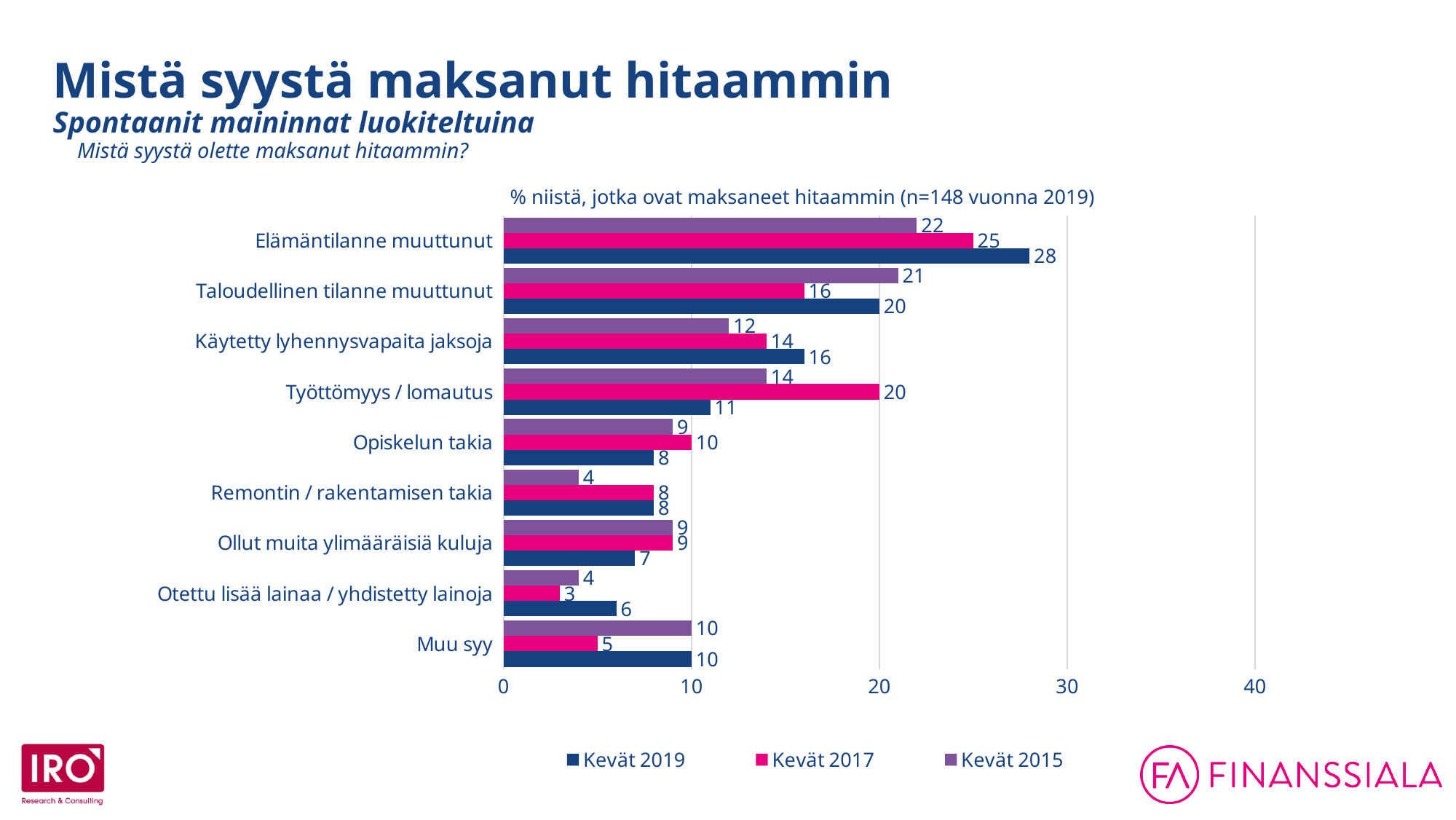
Which category has the lowest Kevät 2017 value? Otettu lisää lainaa / yhdistetty lainoja What is the Kevät 2019 value for Elämäntilanne muuttunut? 28 What is the difference between the Kevät 2019 and Kevät 2015 values for Elämäntilanne muuttunut? 6 What is the Kevät 2017 value for Työttömyys / lomautus? 20 What is the Kevät 2015 value for Taloudellinen tilanne muuttunut? 21 Which category has the highest Kevät 2019 value? Elämäntilanne muuttunut For Työttömyys / lomautus, which is larger: the Kevät 2017 value or the Kevät 2019 value? Kevät 2017 What kind of chart is shown on the slide? Bar chart How many series does the legend list? 3 How many categories are shown on the chart? 9 Is the Kevät 2019 value for Taloudellinen tilanne muuttunut greater or less than 10? greater Which series is shown in pink in the legend? Kevät 2017